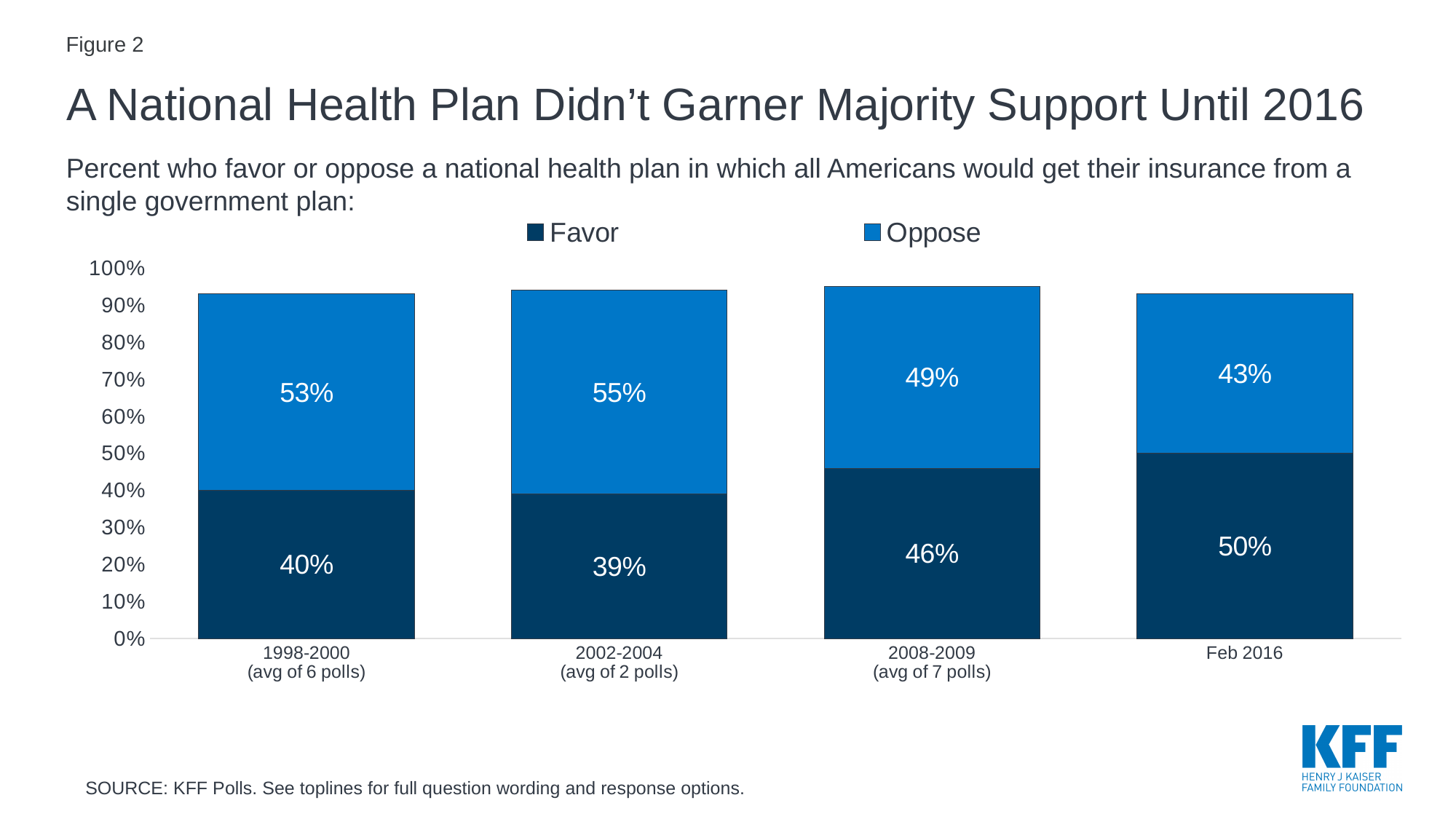
What is the difference between the Oppose and Favor values in 1998-2000? 13% In which period was the Favor share highest? Feb 2016 Does the Favor share rise or fall from 2002-2004 to Feb 2016? Rise In which period was the Oppose share lowest? Feb 2016 What percent favored a national health plan in Feb 2016? 50% What kind of chart is shown? Stacked bar chart How many series does the legend list? 2 What percent opposed a national health plan in 2002-2004? 55% How many time periods are shown on the x axis? 4 What is the Favor value for 2008-2009? 46% What is the combined total of Favor and Oppose for 2002-2004? 94% Which is larger in 2008-2009, Favor or Oppose? Oppose